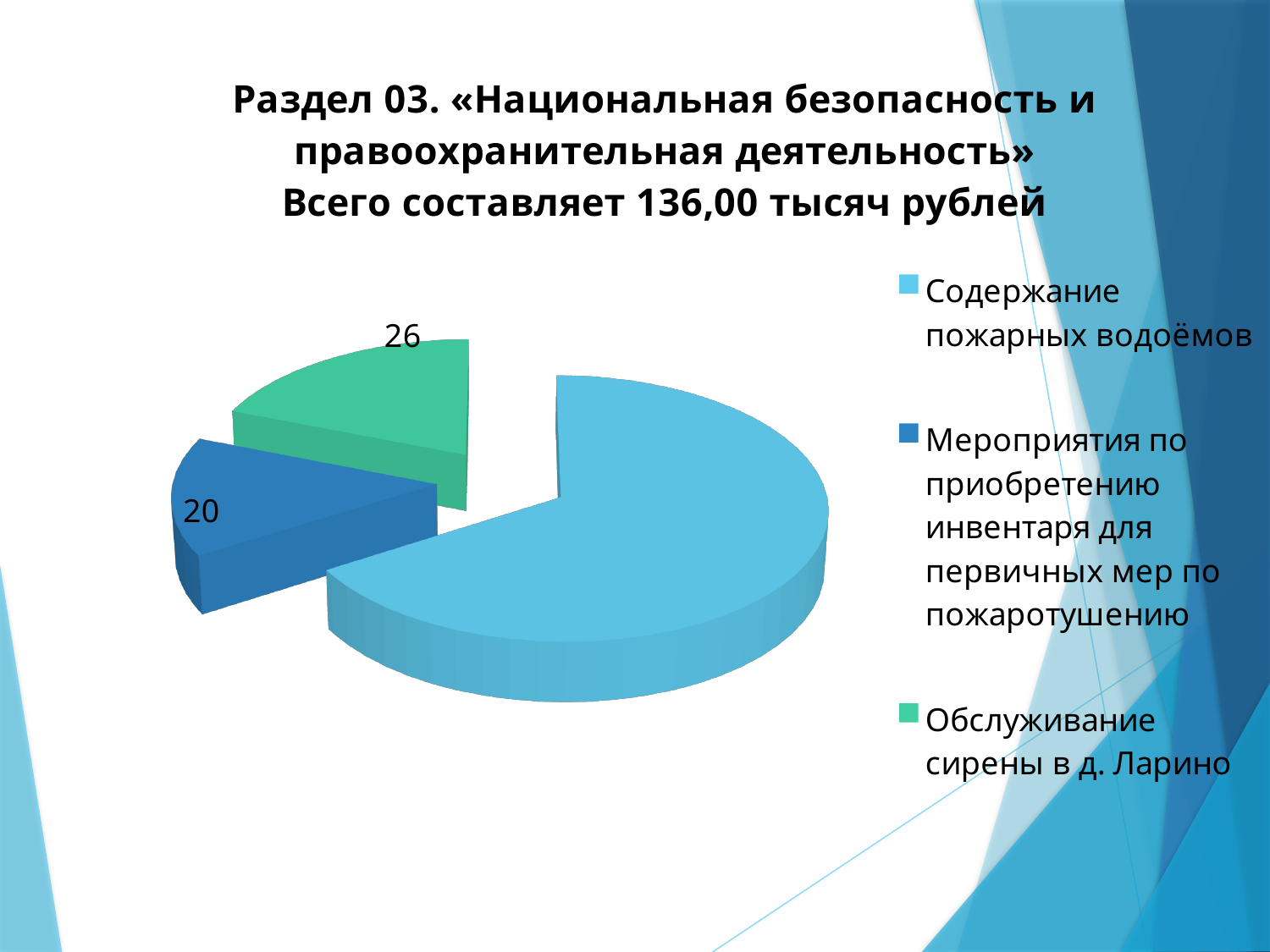
What kind of chart is shown on the slide? pie chart Which is larger: the value for «Обслуживание сирены в д. Ларино» or the value for «Мероприятия по приобретению инвентаря для первичных мер по пожаротушению»? Обслуживание сирены в д. Ларино What is the value shown for «Обслуживание сирены в д. Ларино»? 26 What is the value shown for «Мероприятия по приобретению инвентаря для первичных мер по пожаротушению»? 20 Which legend entry is shown in green? Обслуживание сирены в д. Ларино Which category has the largest slice of the pie? Содержание пожарных водоёмов What total amount does the slide title state for Раздел 03? 136,00 тысяч рублей What is the difference between the values for «Обслуживание сирены в д. Ларино» and «Мероприятия по приобретению инвентаря для первичных мер по пожаротушению»? 6 How many entries does the legend list? 3 How many slices does the pie chart have? 3 Which category has the smallest slice of the pie? Мероприятия по приобретению инвентаря для первичных мер по пожаротушению